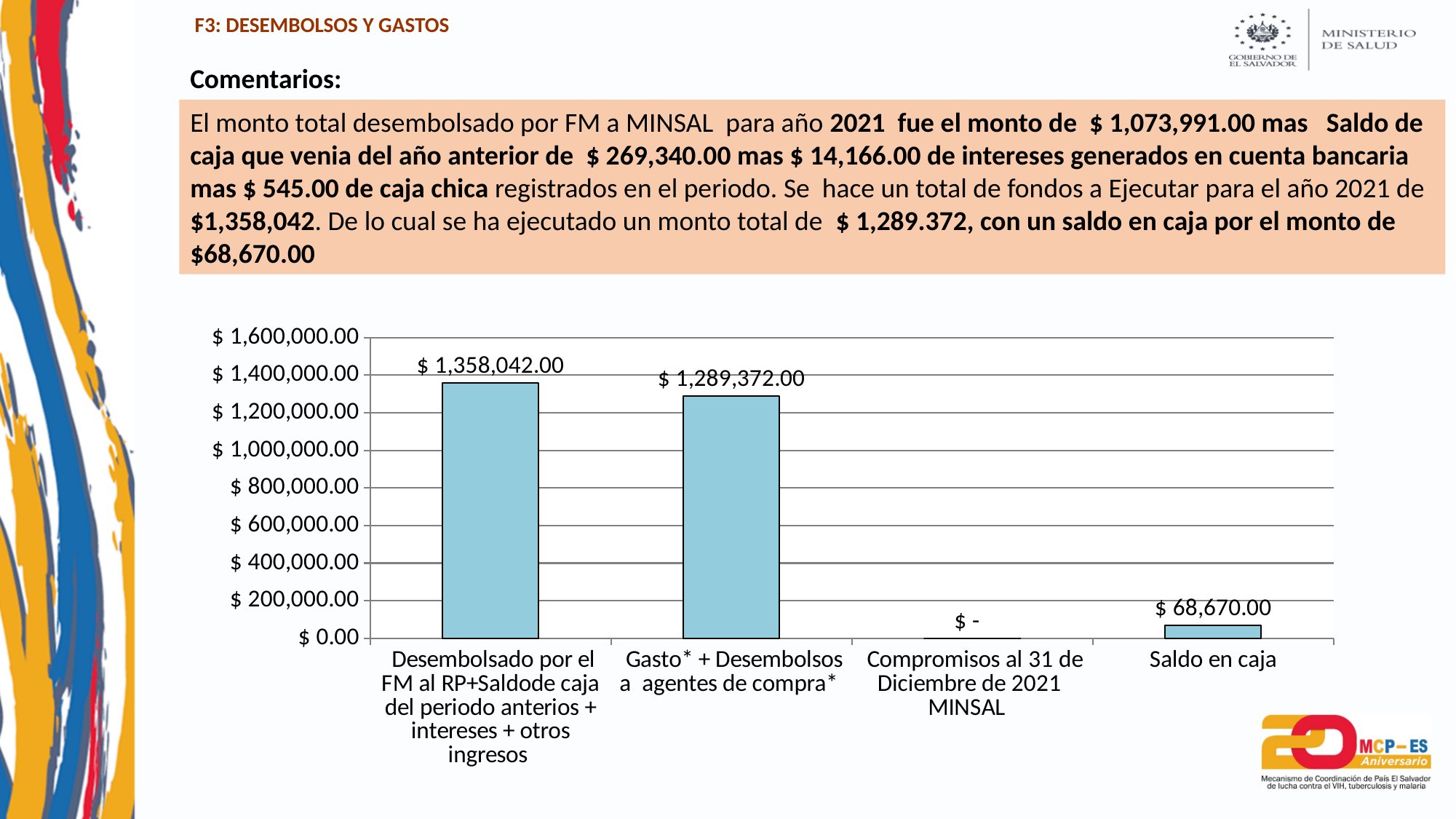
Which category has the lowest value? Compromisos al 31 de Diciembre de 2021 MINSAL Is the value for 'Gasto* + Desembolsos a agentes de compra*' greater or less than $ 1,200,000.00? greater Is the value for 'Saldo en caja' greater or less than $ 200,000.00? less How many categories are shown on the x axis of the chart? 4 What type of chart is shown on the slide? bar chart What is the value of the bar for 'Saldo en caja'? $ 68,670.00 Which is larger, the value for 'Gasto* + Desembolsos a agentes de compra*' or the value for 'Saldo en caja'? Gasto* + Desembolsos a agentes de compra* What is the value of the bar for 'Gasto* + Desembolsos a agentes de compra*'? $ 1,289,372.00 What data label is shown for 'Compromisos al 31 de Diciembre de 2021 MINSAL'? $ - Which category has the highest bar? Desembolsado por el FM al RP+Saldode caja del periodo anterios + intereses + otros ingresos What is the difference between the 'Desembolsado por el FM al RP+Saldode caja del periodo anterios + intereses + otros ingresos' bar and the 'Gasto* + Desembolsos a agentes de compra*' bar? $ 68,670.00 What is the value of the bar for 'Desembolsado por el FM al RP+Saldode caja del periodo anterios + intereses + otros ingresos'? $ 1,358,042.00